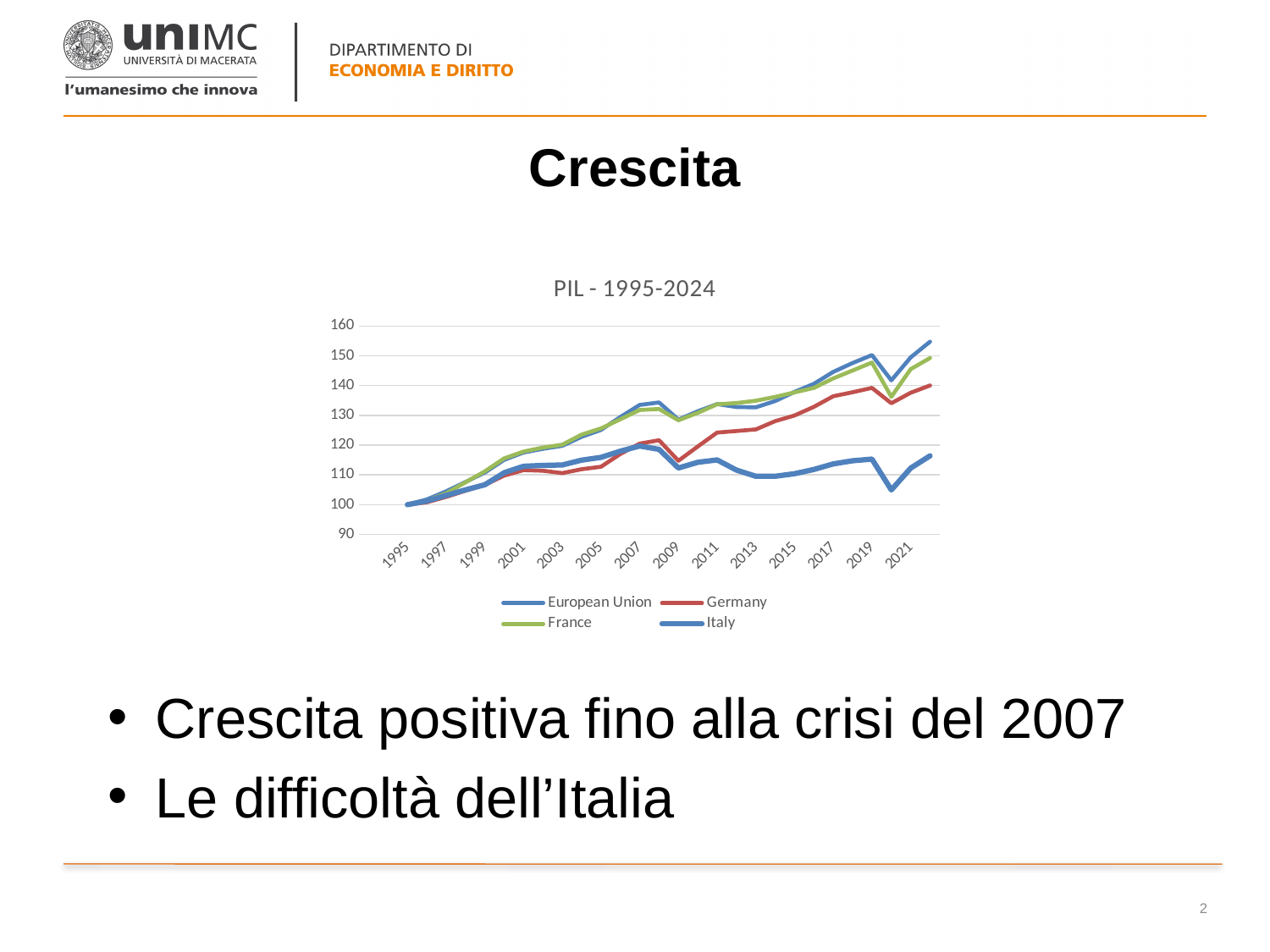
Is the value for Germany in 2017 greater or less than 130? greater Is the value for Germany in 2009 greater or less than 120? less What kind of chart is shown on the slide? line chart Does the Italy series rise or fall between 2007 and 2009? fall Which series has the highest value at the right end of the chart? European Union Which series has the lowest value at the right end of the chart? Italy Is the value for Italy in 2020 greater or less than 110? less How many series does the chart's legend list? 4 In 2019, which is higher, Germany or Italy? Germany What is the title of the chart? PIL - 1995-2024 What value do all the series start at in 1995? 100